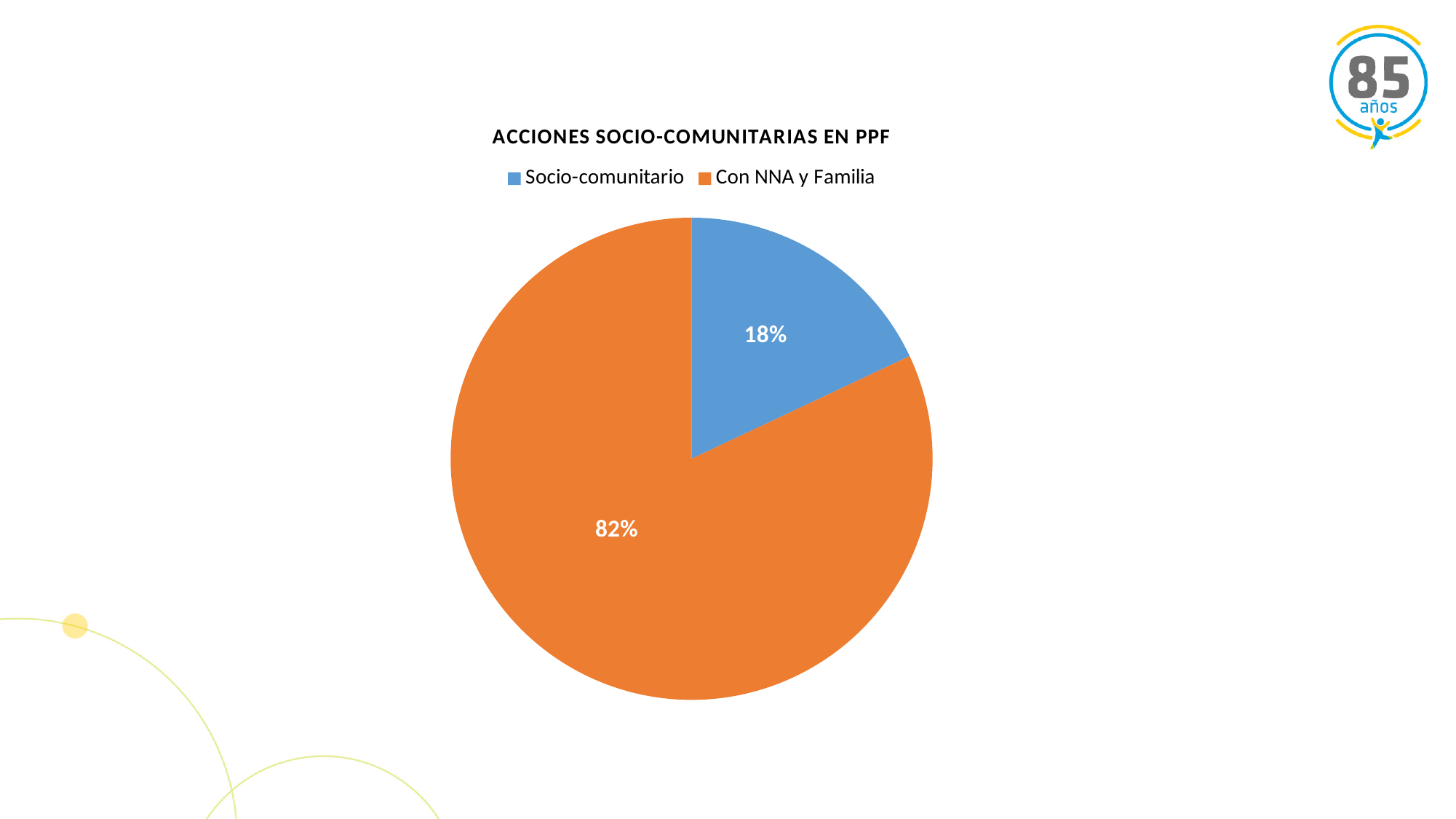
Which category has the largest slice of the pie? Con NNA y Familia How many entries does the legend list? 2 What share of the pie does Socio-comunitario represent? 18% What colour is the Con NNA y Familia slice? orange How many slices does the pie chart have? 2 What share of the pie does Con NNA y Familia represent? 82% Which category has the smallest slice of the pie? Socio-comunitario What type of chart is shown on the slide? pie chart Is the value for Con NNA y Familia greater or less than 50%? greater What is the title of the chart? ACCIONES SOCIO-COMUNITARIAS EN PPF Which is larger, the Socio-comunitario slice or the Con NNA y Familia slice? Con NNA y Familia What is the difference in percentage points between Con NNA y Familia and Socio-comunitario? 64